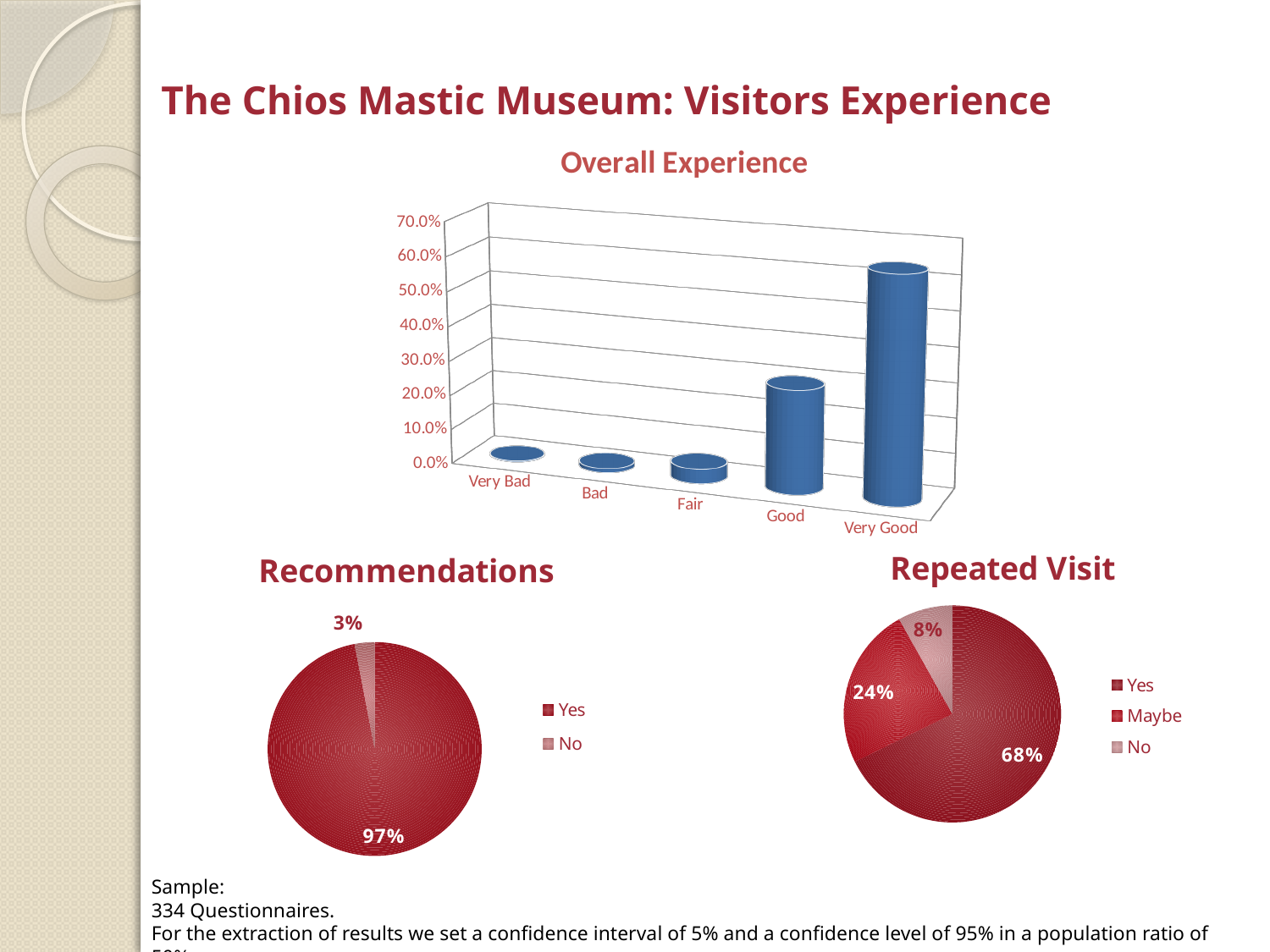
In the Recommendations pie chart, what share of respondents answered Yes? 97% In the Recommendations pie chart, what share of respondents answered No? 3% In the Repeated Visit pie chart, what is the difference between the Yes share and the Maybe share? 44% In the Overall Experience chart, is the value for Very Good greater or less than 40.0%? greater In the Overall Experience chart, which is larger, the value for Good or the value for Very Good? Very Good In the Repeated Visit pie chart, what share of respondents answered Maybe? 24% In the Overall Experience chart, is the value for Good greater or less than 40.0%? less In the Overall Experience chart, is the value for Fair greater or less than 10.0%? less How many categories are shown on the x axis of the Overall Experience chart? 5 In the Overall Experience chart, which category has the highest value? Very Good What kind of chart is the Overall Experience chart? bar chart How many entries does the legend of the Repeated Visit pie chart list? 3